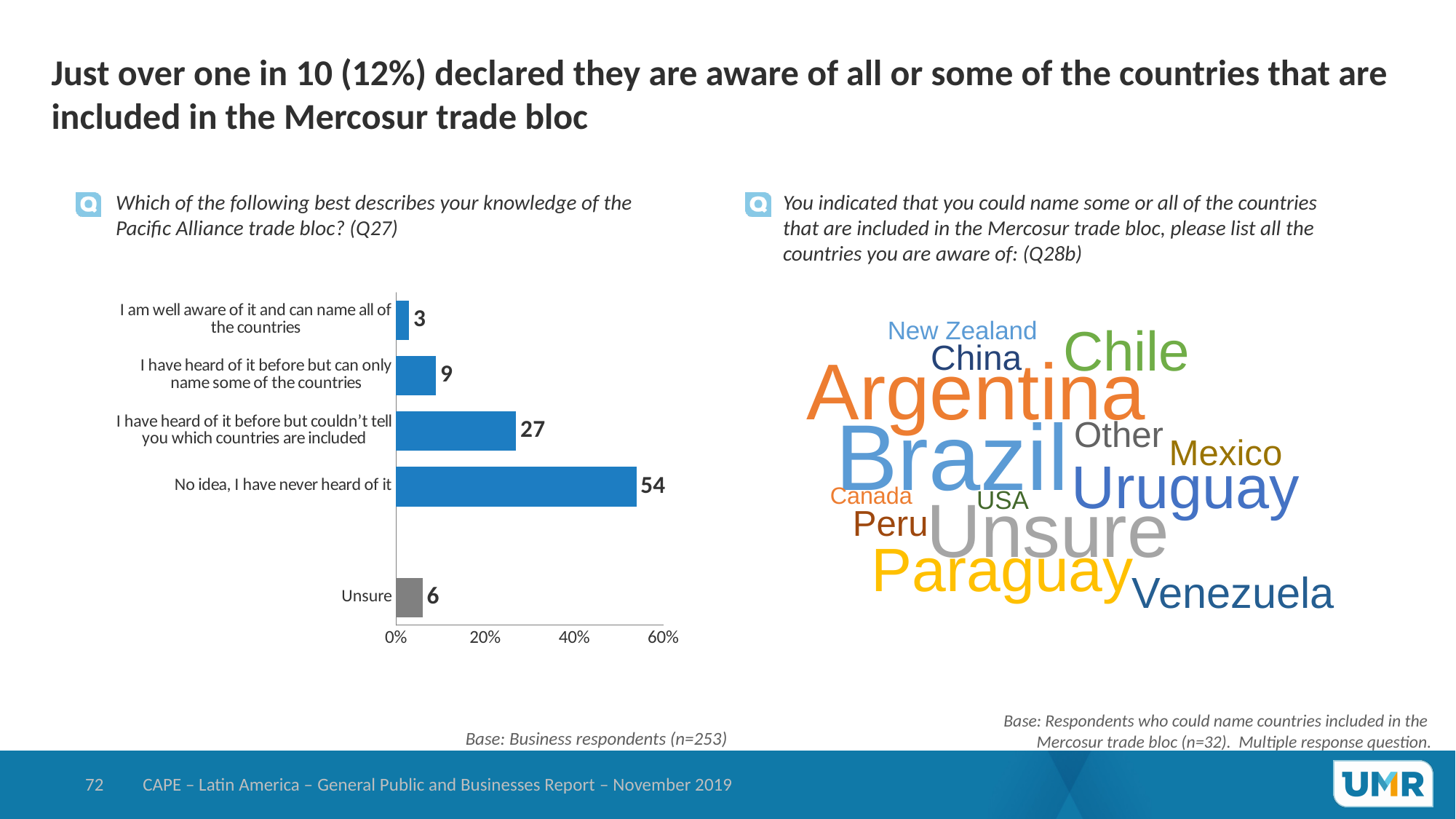
In the bar chart, which category has the lowest value? I am well aware of it and can name all of the countries In the bar chart, which category is shown in grey rather than blue? Unsure In the bar chart, what is the value for "I have heard of it before but couldn't tell you which countries are included"? 27 In the bar chart, what is the value for "No idea, I have never heard of it"? 54 In the bar chart, which is larger: the value for "I have heard of it before but can only name some of the countries" or the value for "Unsure"? I have heard of it before but can only name some of the countries In the bar chart, what is the difference between the values for "No idea, I have never heard of it" and "I have heard of it before but couldn't tell you which countries are included"? 27 In the bar chart, which category has the highest value? No idea, I have never heard of it How many categories are shown in the bar chart? 5 What kind of chart is shown on the left of the slide? bar chart In the bar chart, what is the value for "I am well aware of it and can name all of the countries"? 3 In the bar chart, what is the value for "Unsure"? 6 In the bar chart, is the value for "No idea, I have never heard of it" greater or less than 40%? greater